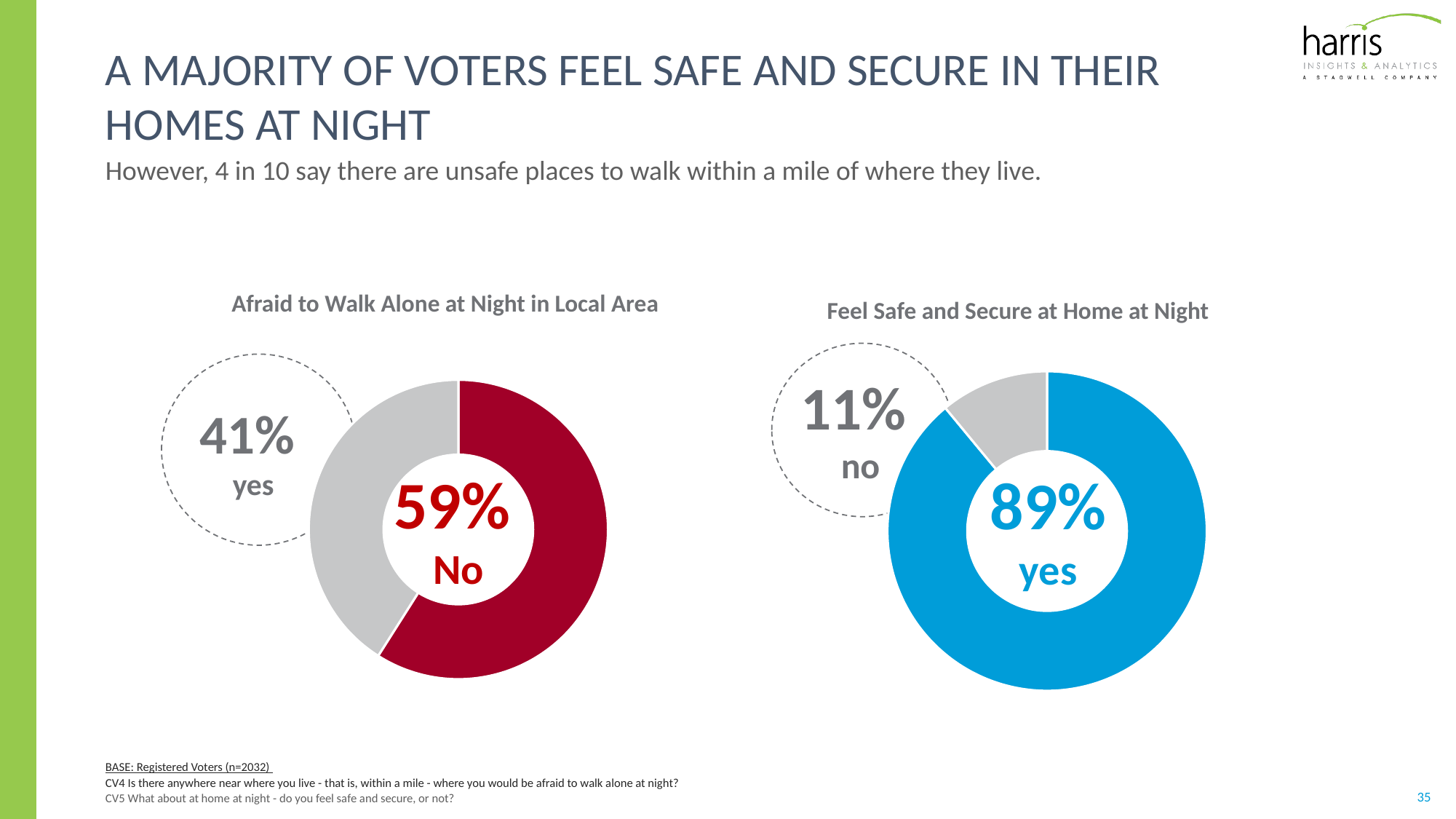
In the 'Feel Safe and Secure at Home at Night' chart, what percentage answered no? 11% In the 'Afraid to Walk Alone at Night in Local Area' chart, what percentage answered yes? 41% In the 'Afraid to Walk Alone at Night in Local Area' chart, which response has the larger share? No In the 'Feel Safe and Secure at Home at Night' chart, which response has the smaller share? no In the 'Feel Safe and Secure at Home at Night' chart, what percentage answered yes? 89% What kind of chart is used for 'Feel Safe and Secure at Home at Night'? Doughnut (pie) chart How many slices does the 'Afraid to Walk Alone at Night in Local Area' chart have? 2 In the 'Feel Safe and Secure at Home at Night' chart, what is the difference between the yes and no shares? 78 percentage points In the 'Afraid to Walk Alone at Night in Local Area' chart, what percentage answered No? 59% In the 'Afraid to Walk Alone at Night in Local Area' chart, what is the difference between the No and yes shares? 18 percentage points Which is larger: the yes share in the 'Afraid to Walk Alone at Night in Local Area' chart or the no share in the 'Feel Safe and Secure at Home at Night' chart? The yes share in the 'Afraid to Walk Alone at Night in Local Area' chart What colour is the yes slice in the 'Feel Safe and Secure at Home at Night' chart? Blue